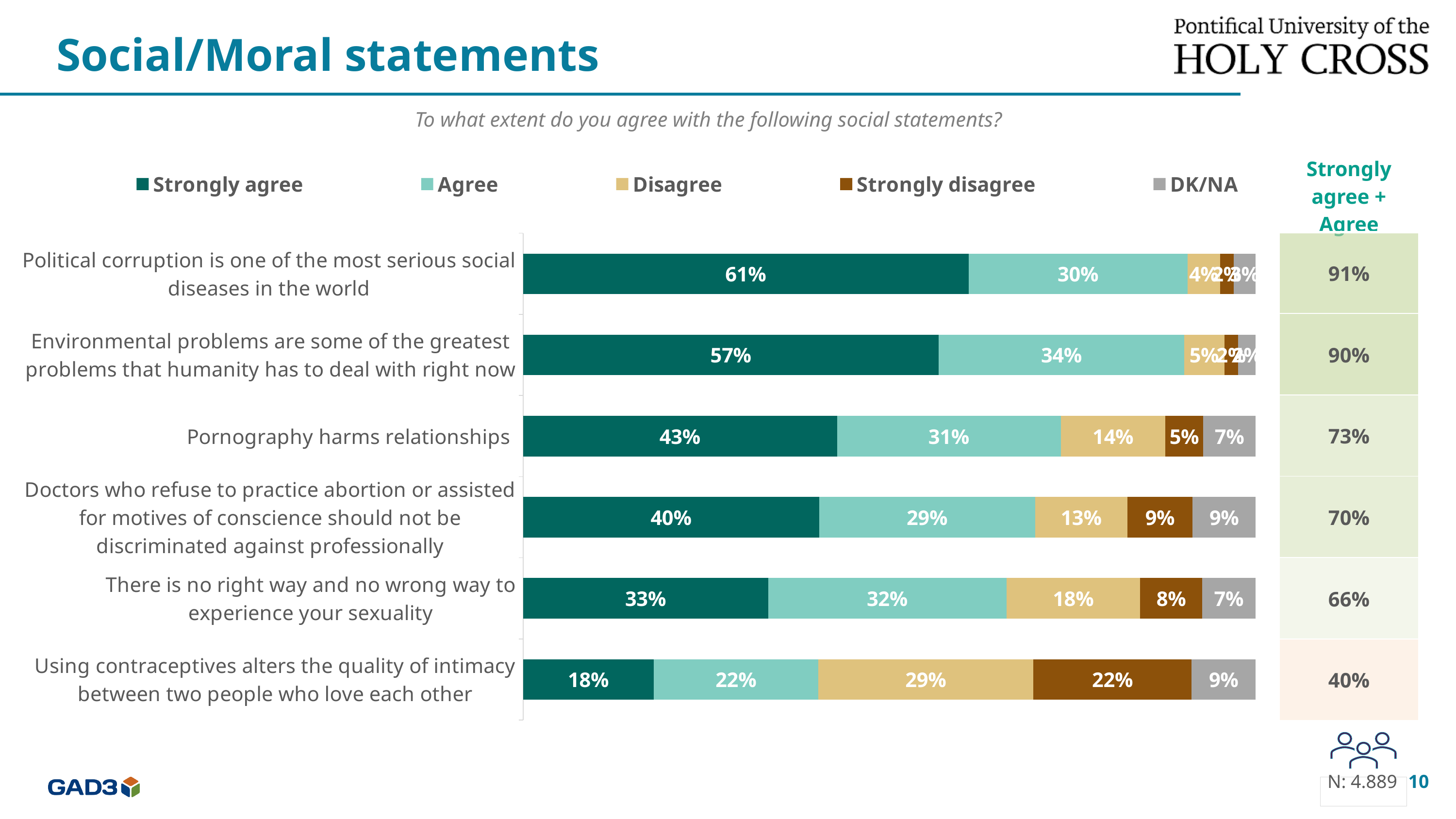
What percentage strongly disagree that using contraceptives alters the quality of intimacy between two people who love each other? 22% How many series does the legend list? 5 What is the DK/NA percentage for the statement 'Pornography harms relationships'? 7% What is the combined 'Strongly agree + Agree' percentage for the statement about doctors who refuse to practice abortion or assisted suicide for motives of conscience? 70% What is the difference between the 'Strongly agree' percentages for 'Pornography harms relationships' and 'There is no right way and no wrong way to experience your sexuality'? 10% Which statement has the highest 'Strongly agree' percentage? Political corruption is one of the most serious social diseases in the world How many statements are shown in the chart? 6 Which is larger: the 'Disagree' percentage for the contraceptives statement or the 'Disagree' percentage for the sexuality statement? The contraceptives statement (29%) Which statement has the lowest combined 'Strongly agree + Agree' percentage? Using contraceptives alters the quality of intimacy between two people who love each other What percentage agree (not strongly) that environmental problems are some of the greatest problems that humanity has to deal with right now? 34% What kind of chart is shown on the slide? Stacked bar chart What percentage strongly agree that political corruption is one of the most serious social diseases in the world? 61%